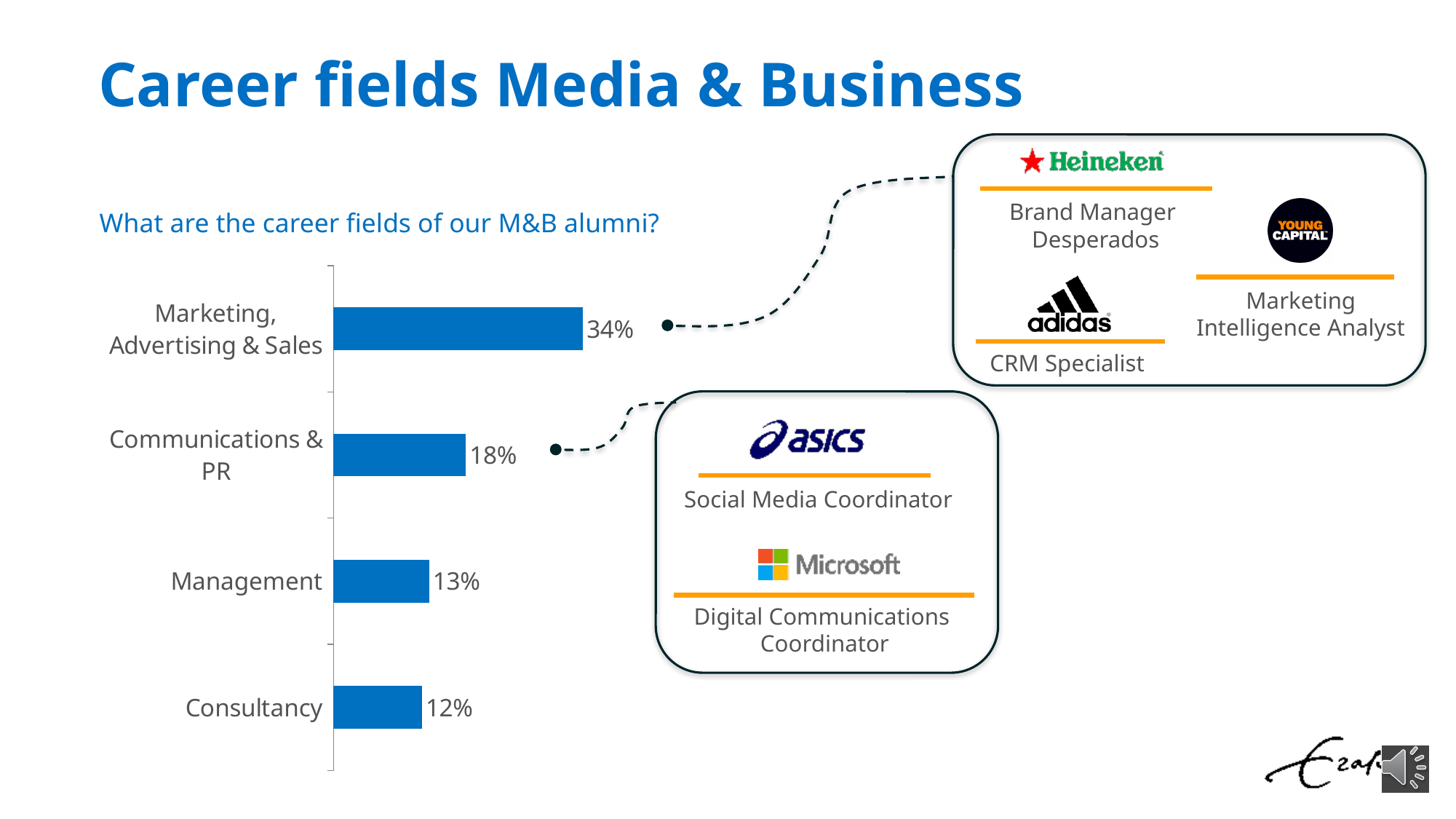
What question does the chart's subtitle ask? What are the career fields of our M&B alumni? Which career field has the lowest share of alumni? Consultancy What type of chart is used on this slide? Bar chart Which is larger, the value for Communications & PR or the value for Management? Communications & PR How many career fields are shown in the chart? 4 Which career field has the highest share of alumni? Marketing, Advertising & Sales What is the value shown for Consultancy? 12% What is the difference between the values for Marketing, Advertising & Sales and Communications & PR? 16% What is the value shown for Management? 13% What is the difference between the values for Management and Consultancy? 1% What percentage of M&B alumni work in Marketing, Advertising & Sales? 34% What is the value shown for Communications & PR? 18%